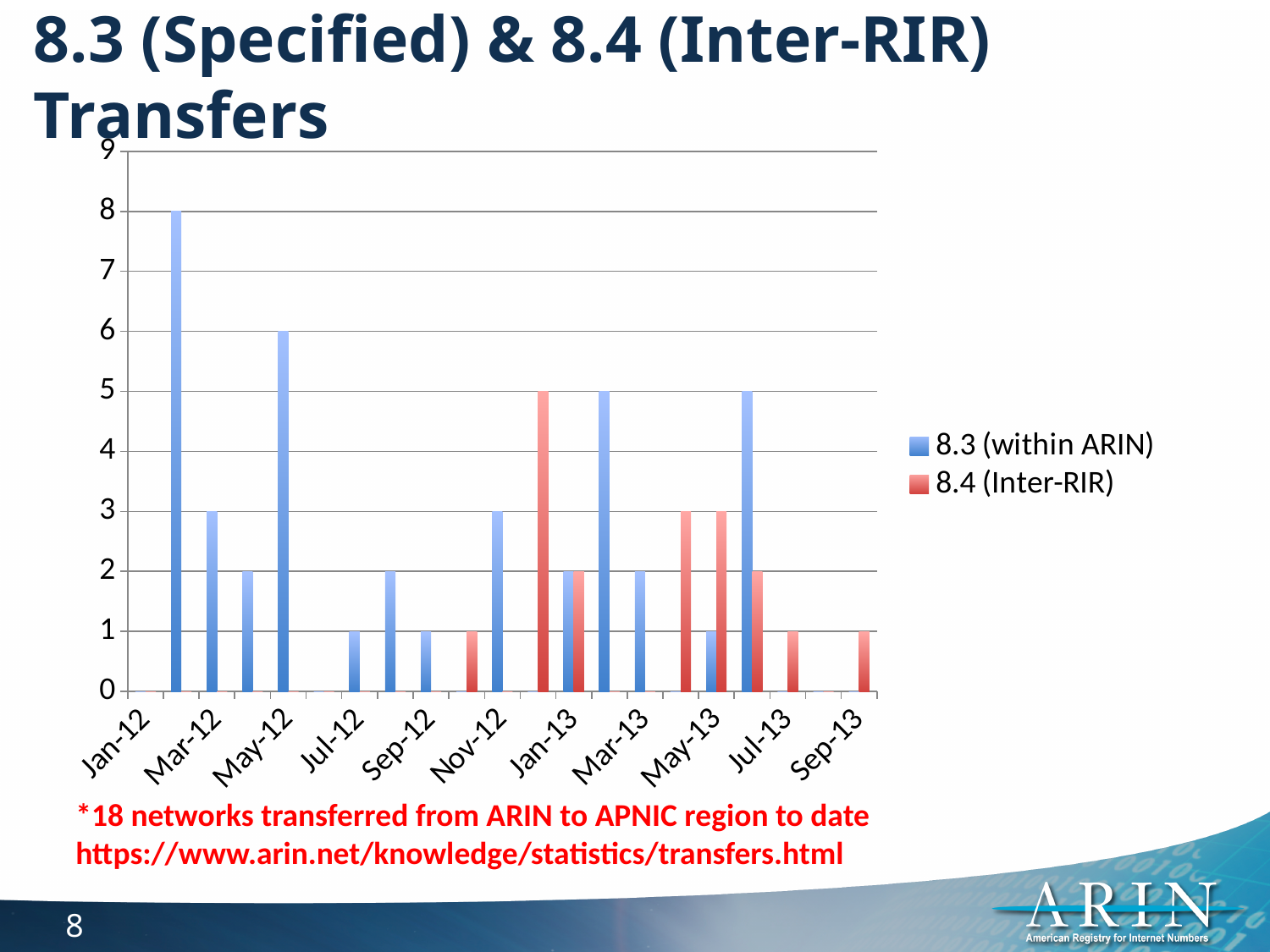
Is the value of 8.3 (within ARIN) for May-12 greater or less than 5? greater What is the highest value reached by the 8.3 (within ARIN) series? 8 What are the two series named in the chart legend? 8.3 (within ARIN) and 8.4 (Inter-RIR) How many series does the chart legend list? 2 What is the value of 8.4 (Inter-RIR) for May-13? 3 What is the highest value reached by the 8.4 (Inter-RIR) series? 5 For May-13, which series has the larger value, 8.3 (within ARIN) or 8.4 (Inter-RIR)? 8.4 (Inter-RIR) How many month labels are shown on the x axis? 11 What is the value of 8.3 (within ARIN) for May-12? 6 What type of chart is shown on the slide? bar chart What is the value of 8.3 (within ARIN) for Nov-12? 3 What is the value of 8.3 (within ARIN) for Mar-12? 3